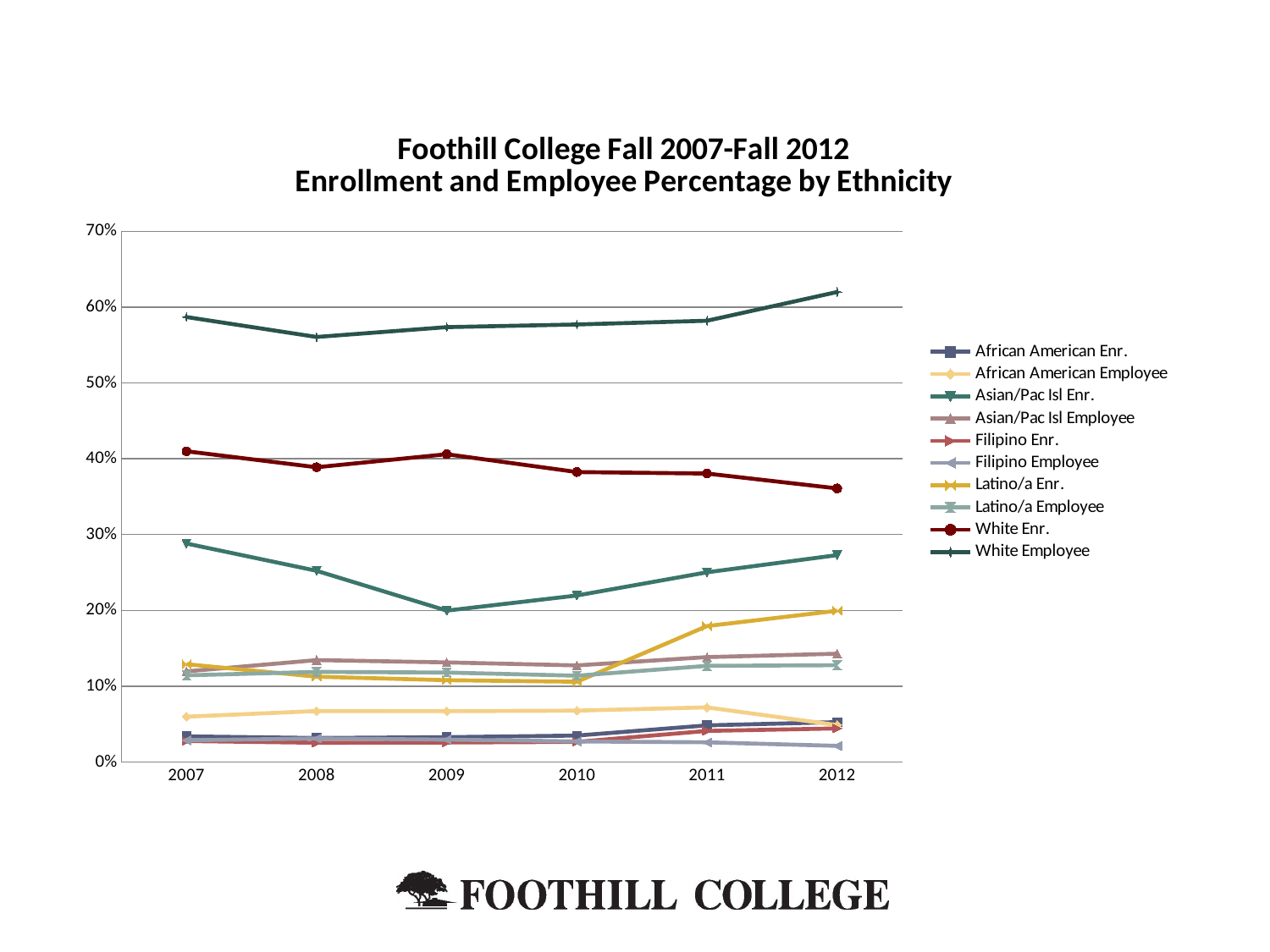
Which series has the highest value in 2012? White Employee How many series does the legend list? 10 What is the title of the chart? Foothill College Fall 2007-Fall 2012 Enrollment and Employee Percentage by Ethnicity Is the value for White Enr. in 2012 greater or less than 40%? less Which series has the lowest value in 2012? Filipino Employee Does the White Enr. line rise or fall overall from 2007 to 2012? fall Is the value for Asian/Pac Isl Enr. in 2007 greater or less than 20%? greater Is the value for White Employee in 2012 greater or less than 60%? greater How many years are plotted along the x axis? 6 In 2007, which is larger: White Enr. or Asian/Pac Isl Enr.? White Enr. In 2012, which is larger: Latino/a Enr. or Latino/a Employee? Latino/a Enr. What kind of chart is shown on the slide? line chart